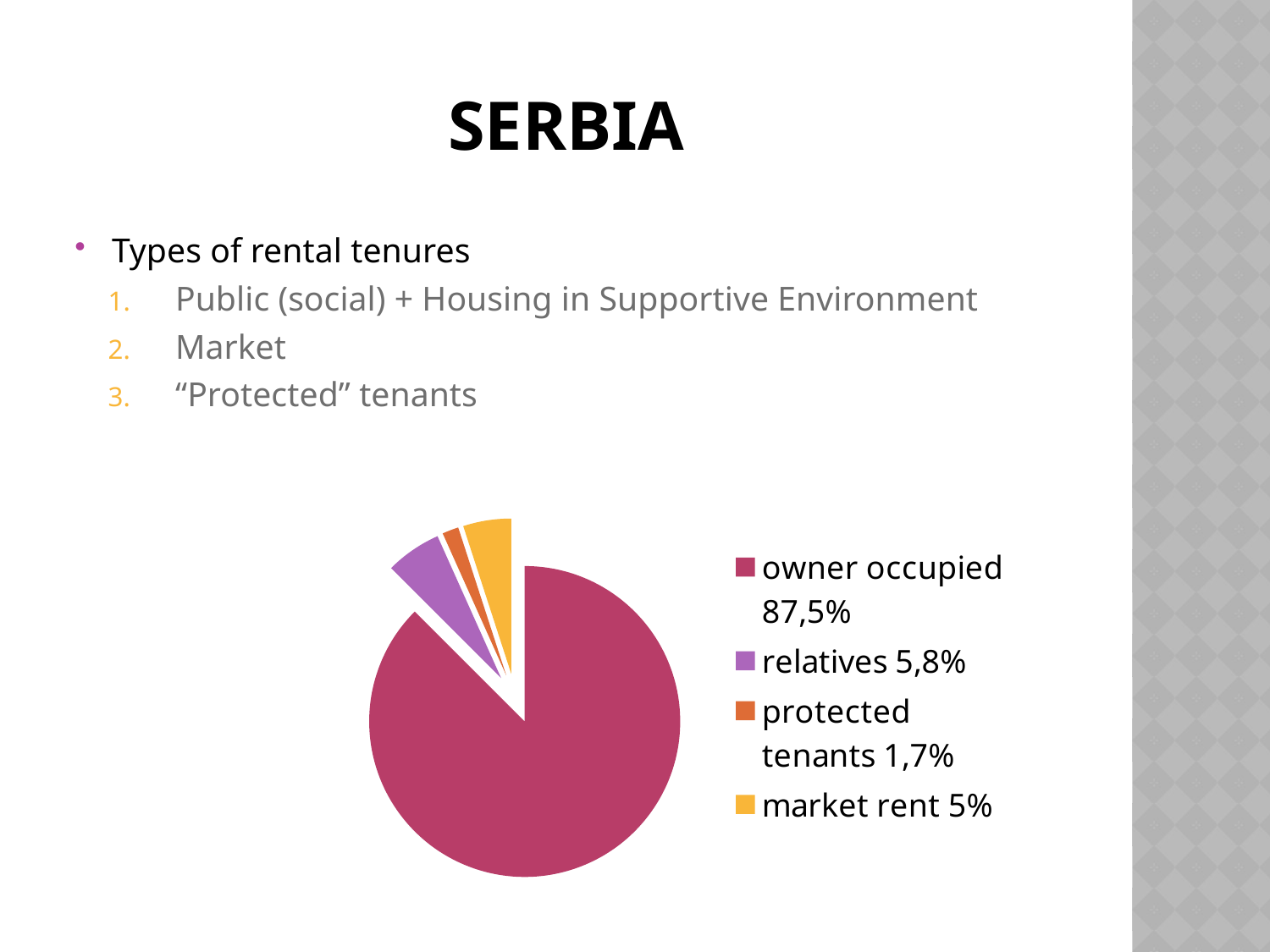
What share of the pie is owner occupied? 87,5% Which category has the largest slice of the pie? owner occupied What share of the pie is protected tenants? 1,7% What is the difference between the market rent share and the protected tenants share? 3,3% What colour is the owner occupied slice in the pie chart? magenta (dark pink) Which category has the smallest slice of the pie? protected tenants What share of the pie is market rent? 5% Which is larger, the relatives slice or the market rent slice? relatives How many slices does the pie chart have? 4 What kind of chart is shown on the slide? pie chart What is the difference between the owner occupied share and the relatives share? 81,7%